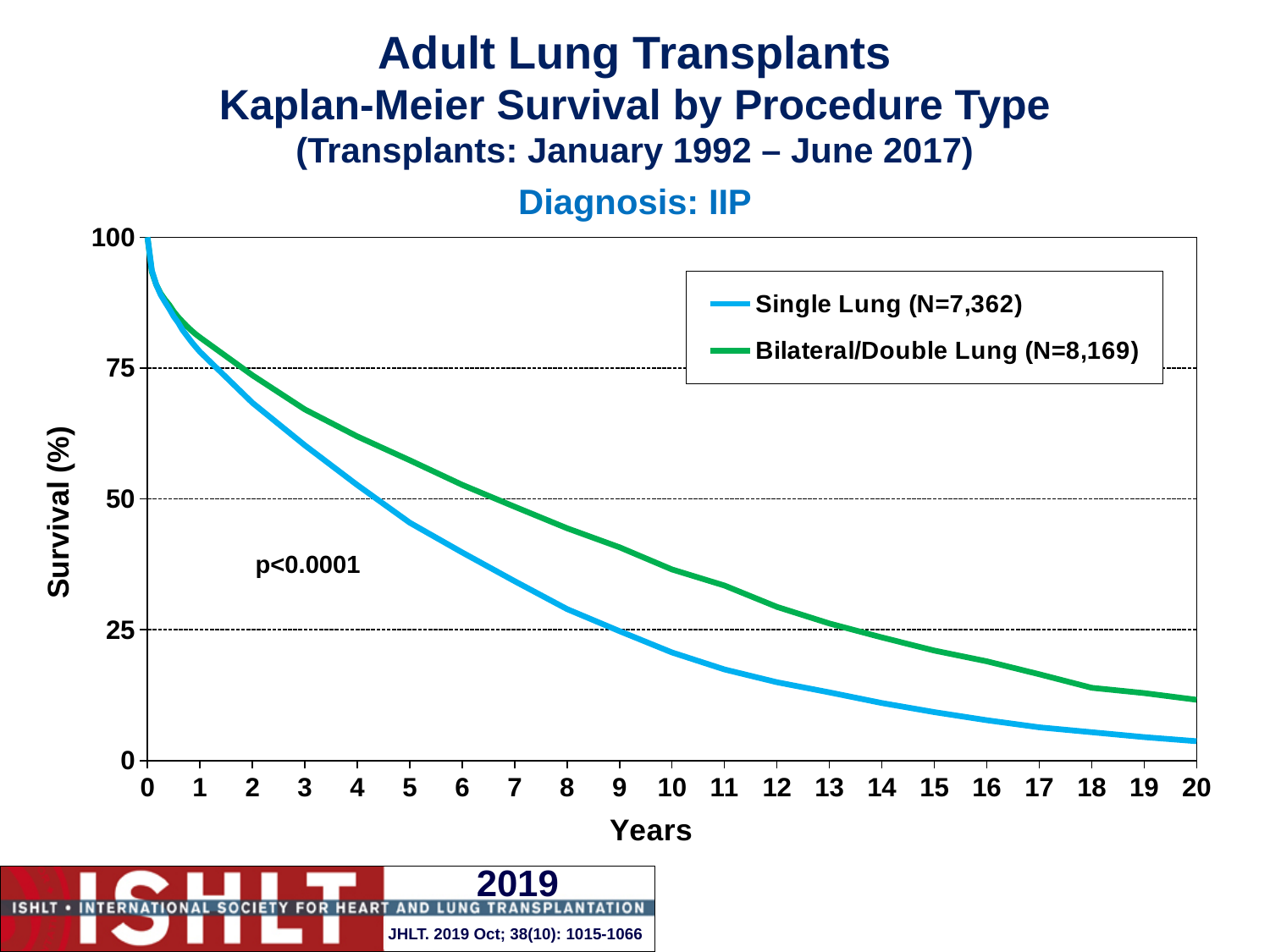
Is the survival value for Bilateral/Double Lung at year 20 greater or less than 25? less What p-value is printed on the chart? p<0.0001 What is the N value shown in the legend for Single Lung? N=7,362 Is the survival value for Bilateral/Double Lung at year 5 greater or less than 50? greater What kind of chart is shown on the slide? line chart Is the survival value for Bilateral/Double Lung at year 1 greater or less than 75? greater How many series does the legend list? 2 Do the survival curves rise or fall as years increase? fall At year 10, which series has higher survival, Single Lung or Bilateral/Double Lung? Bilateral/Double Lung